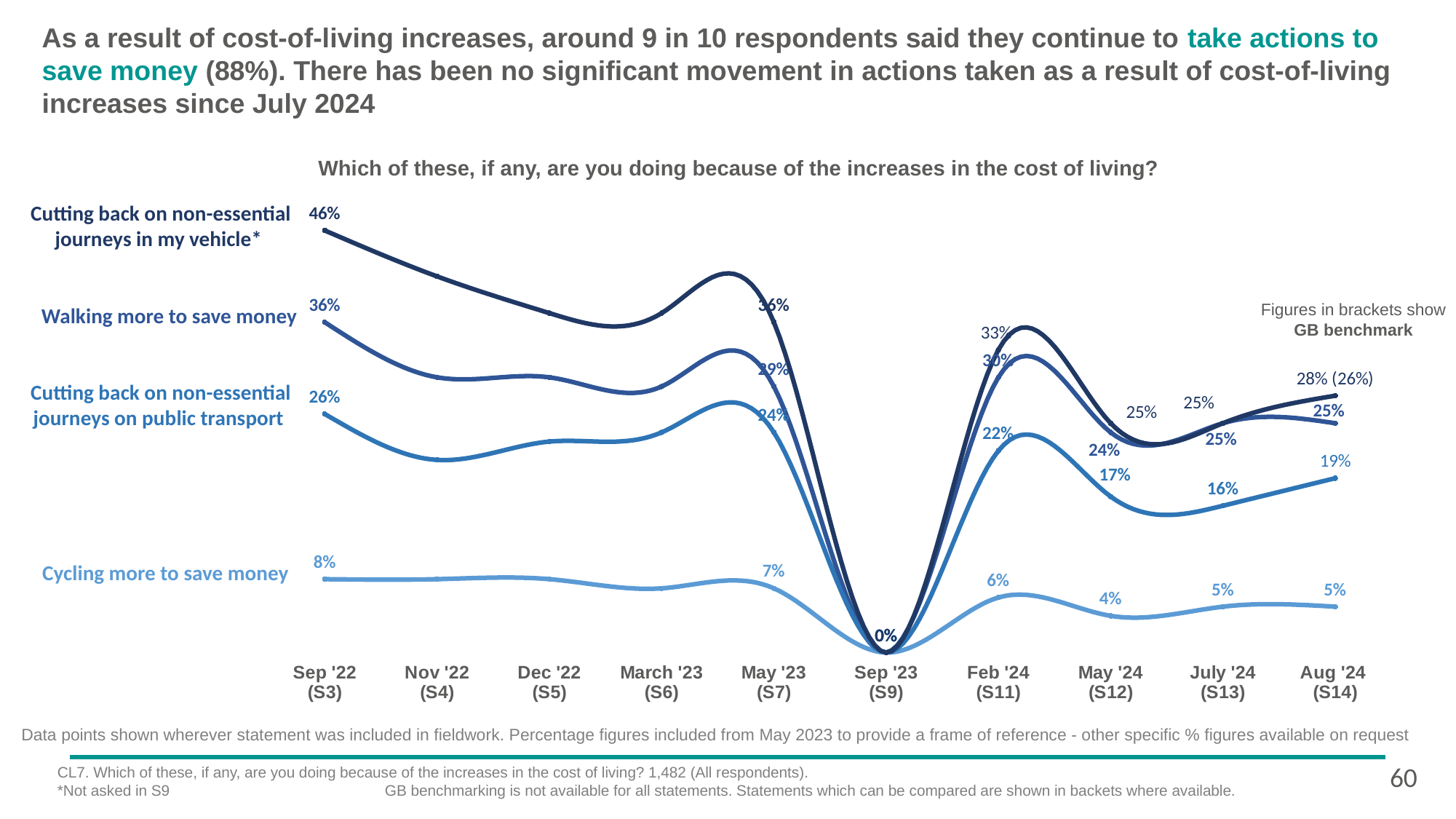
What kind of chart is shown on the slide? Line chart In Sep '22 (S3), what is the difference in percentage points between cutting back on non-essential journeys in my vehicle (46%) and walking more to save money (36%)? 10 percentage points What is the GB benchmark figure shown in brackets for cutting back on non-essential journeys in my vehicle in Aug '24? 26% For 'Cutting back on non-essential journeys on public transport', which is higher: Feb '24 (S11) or May '24 (S12)? Feb '24 (S11) How many lines (statements) are plotted on the chart? 4 What is the value for 'Cutting back on non-essential journeys on public transport' in May '24 (S12)? 17% What is the value for 'Cutting back on non-essential journeys in my vehicle' in Aug '24 (S14)? 28% What is the value for 'Walking more to save money' in Aug '24 (S14)? 25% Which statement has the lowest value in Aug '24 (S14)? Cycling more to save money Which statement has the highest value in Sep '22 (S3)? Cutting back on non-essential journeys in my vehicle How many survey waves (points) are shown along the x axis of the chart? 10 What percentage said they were cycling more to save money in Sep '22 (S3)? 8%